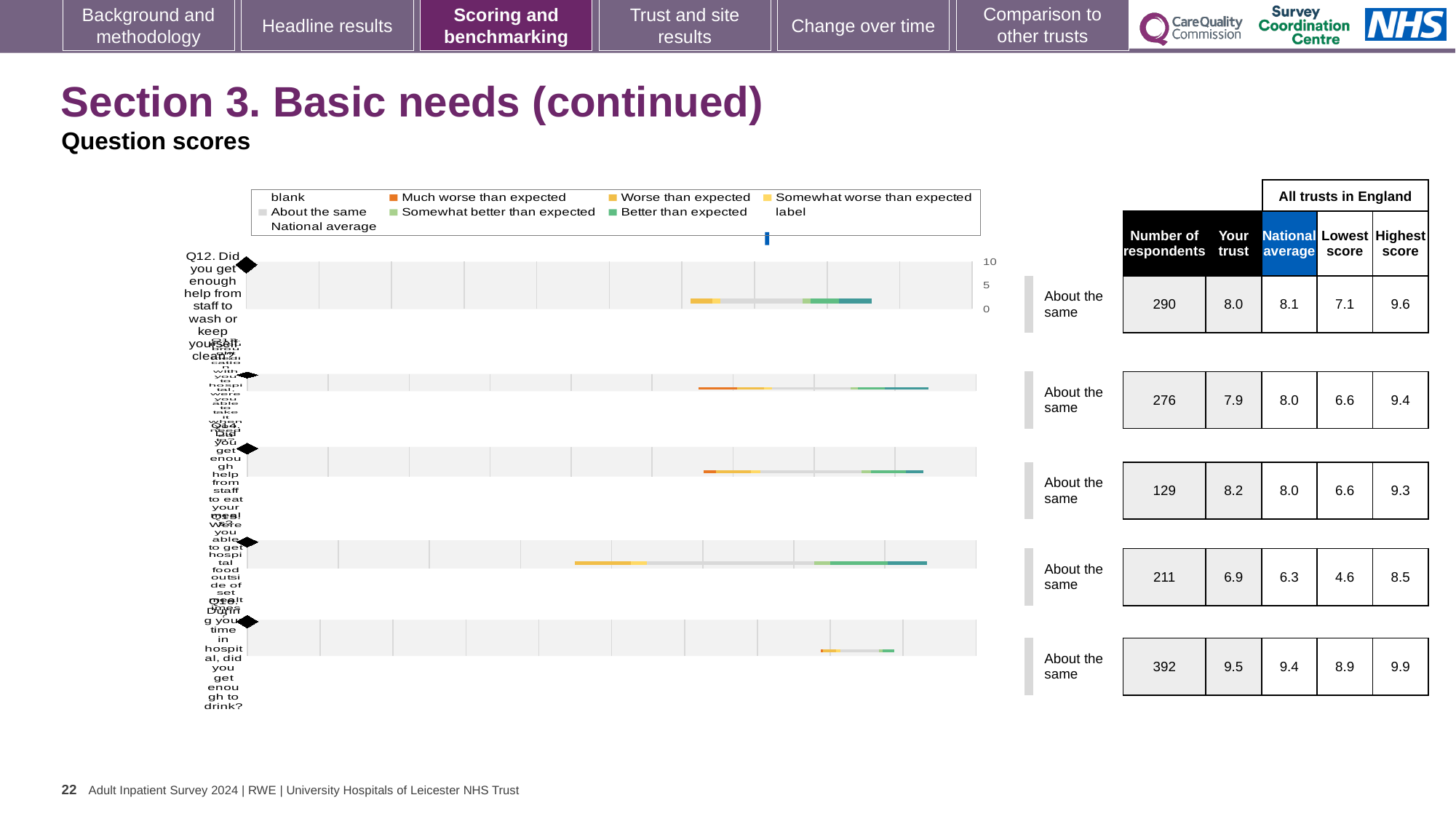
What is the 'Your trust' score for the last question row, Q16 (did you get enough to drink)? 9.5 How many respondents answered Q12 (help from staff to wash or keep yourself clean)? 290 For Q12, which is larger: the 'Your trust' score or the national average? National average (8.1) What is the 'Your trust' score for Q12 (help from staff to wash or keep yourself clean)? 8.0 What kind of chart is used to show the question scores on this slide? bar chart Which question row has the fewest respondents? Q14 (help from staff to eat your meals), 129 Which question row has the highest 'Your trust' score? Q16 (did you get enough to drink), 9.5 What is the national average for Q12 (help from staff to wash or keep yourself clean)? 8.1 What is the difference between the highest score (9.6) and the lowest score (7.1) across all trusts for Q12? 2.5 How many question rows are plotted in the chart? 5 Which question row has the lowest 'Your trust' score? Q15 (hospital food outside of set meal times), 6.9 What benchmark category is shown for every question row on this slide? About the same